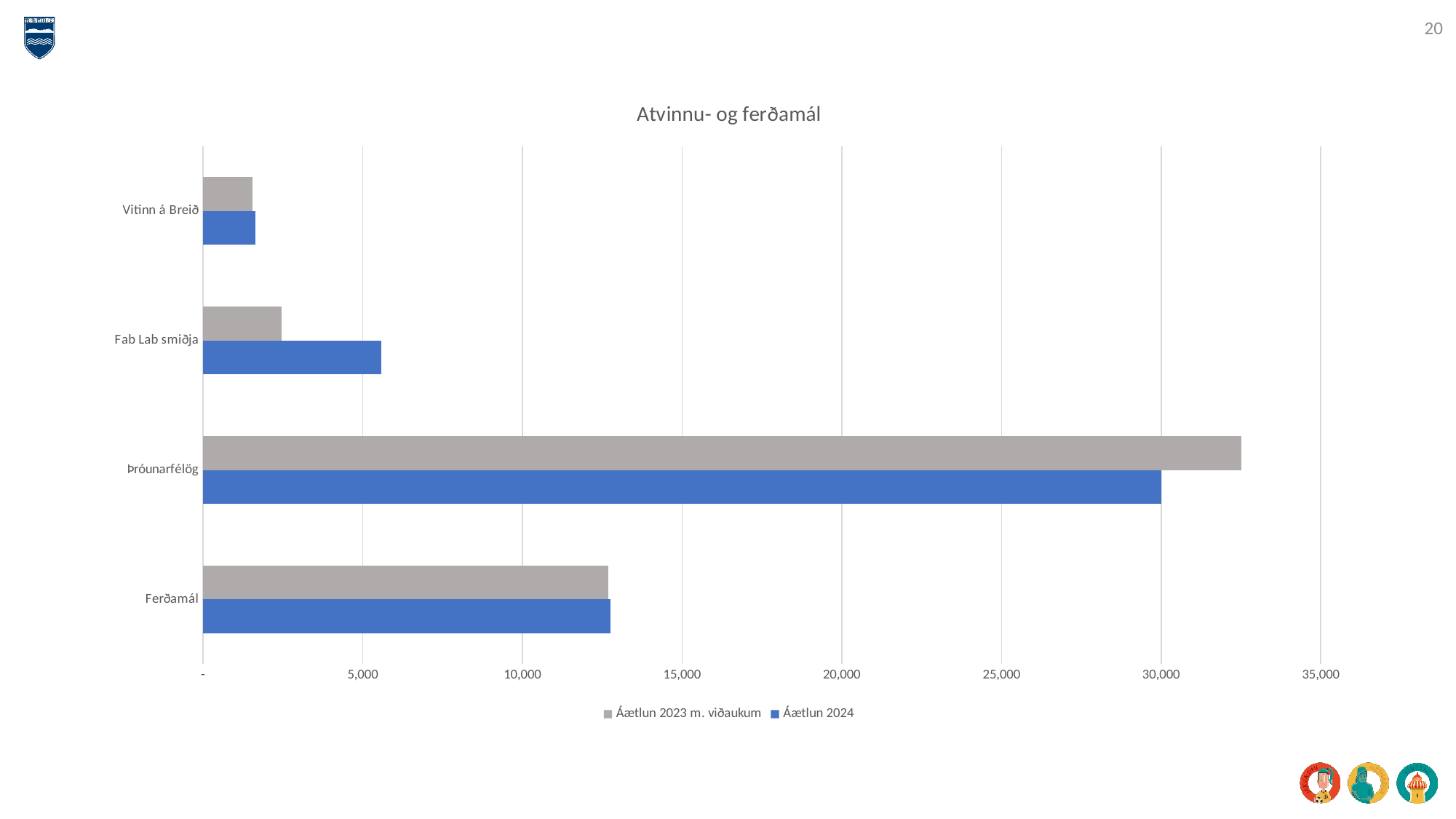
Is the Áætlun 2024 value for Fab Lab smiðja greater or less than 5,000? greater What type of chart is shown on the slide? Bar chart Which category has the lowest value for Áætlun 2023 m. viðaukum? Vitinn á Breið Is the Áætlun 2024 value for Ferðamál greater or less than 10,000? greater Which category has the highest value for Áætlun 2024? Þróunarfélög How many series does the legend list? 2 For Fab Lab smiðja, which series has the larger value: Áætlun 2023 m. viðaukum or Áætlun 2024? Áætlun 2024 Is the Áætlun 2023 m. viðaukum value for Þróunarfélög greater or less than 30,000? greater How many categories are shown on the chart? 4 What is the title of the chart? Atvinnu- og ferðamál For Þróunarfélög, which series has the larger value: Áætlun 2023 m. viðaukum or Áætlun 2024? Áætlun 2023 m. viðaukum